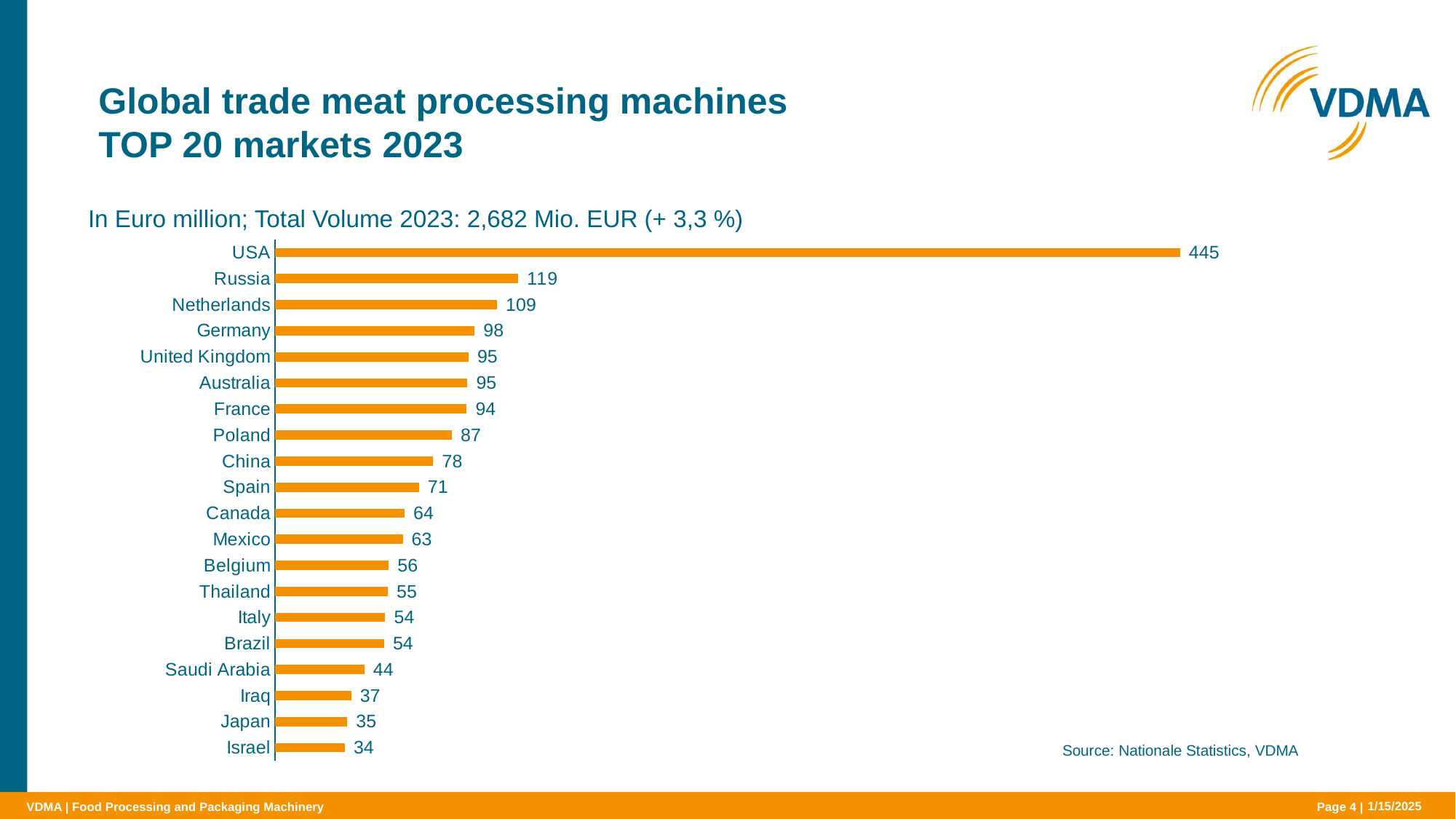
What kind of chart is shown on the slide? Bar chart Which is larger, the value for China or the value for Spain? China What unit are the values in the chart given in? Euro million What is the total volume for 2023 stated in the chart subtitle? 2,682 Mio. EUR What is the value for Russia? 119 What is the difference between the values for Netherlands and Germany? 11 How many countries are shown in the chart? 20 What is the difference between the values for USA and Russia? 326 Which country has the highest value? USA What is the value for Poland? 87 Which country has the lowest value? Israel What is the value for Saudi Arabia? 44